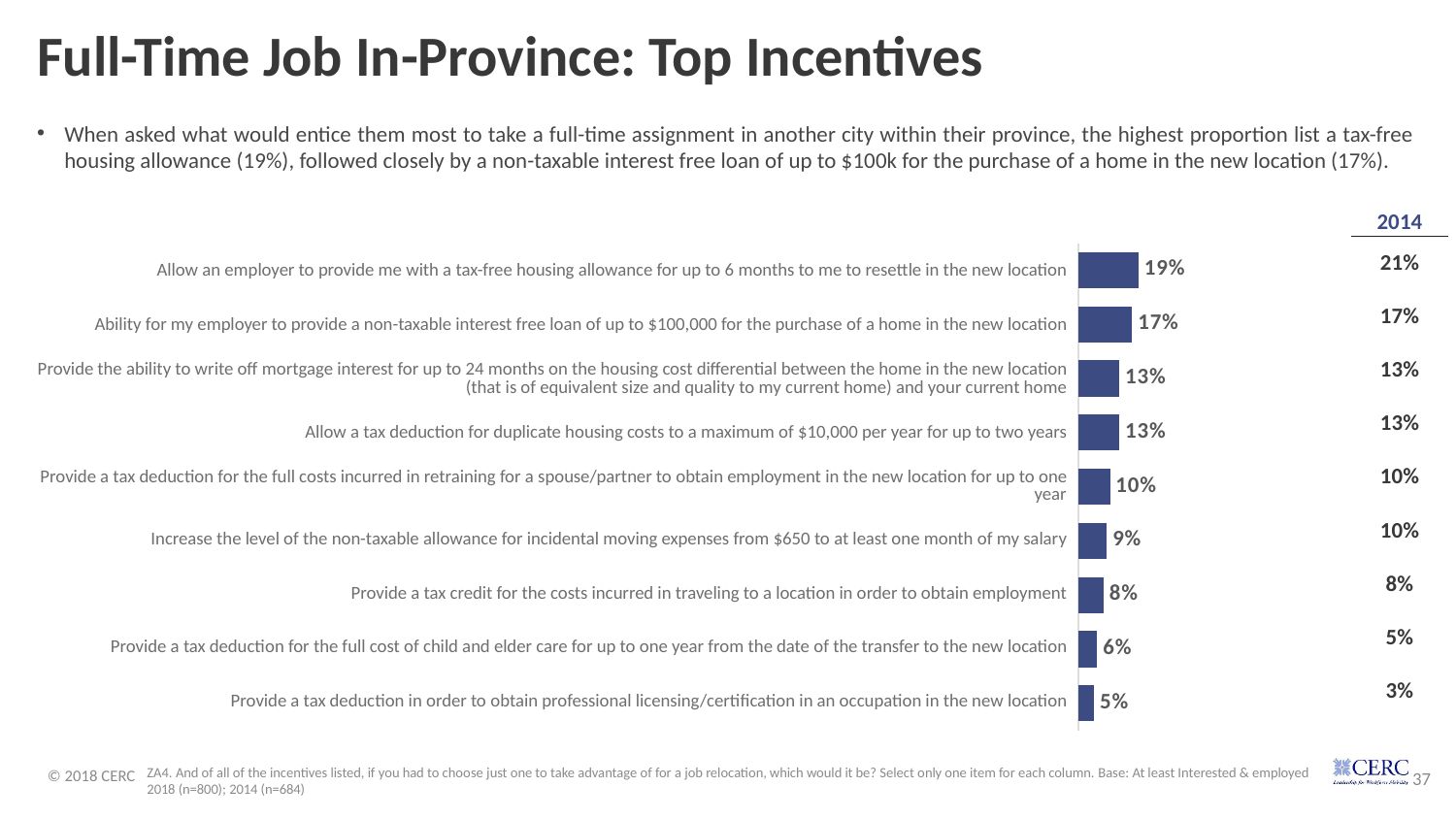
What is the value for the tax deduction for the full cost of child and elder care for up to one year? 6% What is the difference between the value for the tax-free housing allowance (19%) and the value for the tax deduction for professional licensing/certification (5%)? 14% What kind of chart is shown on the slide? bar chart What is the title of the slide containing the bar chart? Full-Time Job In-Province: Top Incentives How many incentive categories are plotted in the bar chart? 9 What is the value for the non-taxable interest free loan of up to $100,000 for the purchase of a home? 17% What is the value for increasing the non-taxable allowance for incidental moving expenses from $650 to at least one month of salary? 9% Which incentive has the highest value in the bar chart? Allow an employer to provide me with a tax-free housing allowance for up to 6 months to me to resettle in the new location What is the value for the tax deduction for duplicate housing costs to a maximum of $10,000 per year? 13% Which is larger: the value for the tax credit for costs incurred in traveling to a location to obtain employment, or the value for the tax deduction for retraining a spouse/partner? Tax deduction for retraining a spouse/partner Which incentive has the lowest value in the bar chart? Provide a tax deduction in order to obtain professional licensing/certification in an occupation in the new location What is the value for the tax-free housing allowance for up to 6 months incentive? 19%